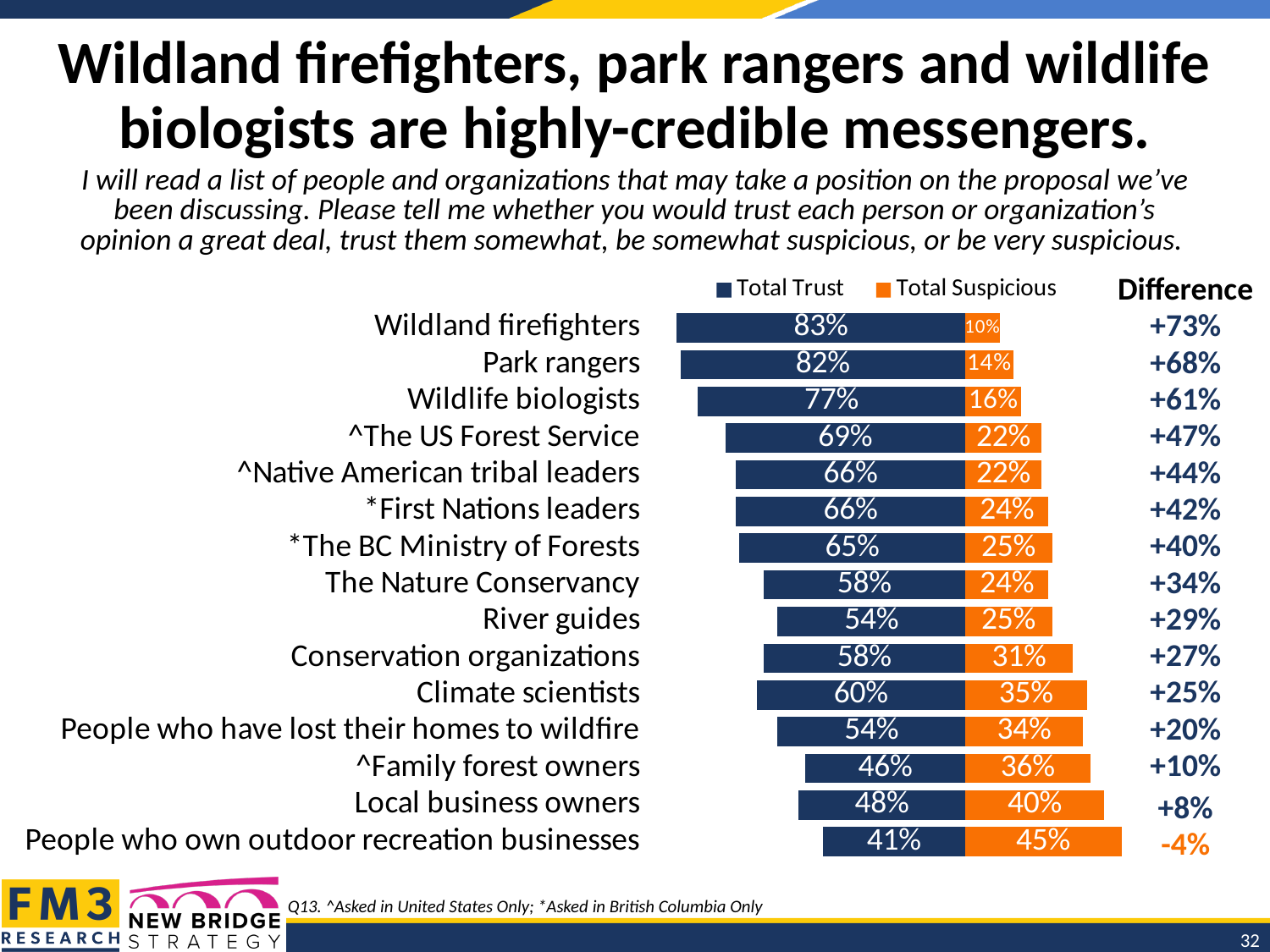
How many series does the legend list? 2 Which category has the highest Total Trust value? Wildland firefighters What colour represents the Total Suspicious series? Orange What is the difference between the Total Trust and Total Suspicious values for Park rangers? 68% Which category has the lowest Total Suspicious value? Wildland firefighters What is the Total Trust value for People who own outdoor recreation businesses? 41% What kind of chart is shown on the slide? Bar chart What is the Total Suspicious value for Climate scientists? 35% What is the Difference value shown for The Nature Conservancy? +34% How many categories are shown in the chart? 15 Which is larger for Local business owners, Total Trust or Total Suspicious? Total Trust What is the Total Trust value for Wildland firefighters? 83%